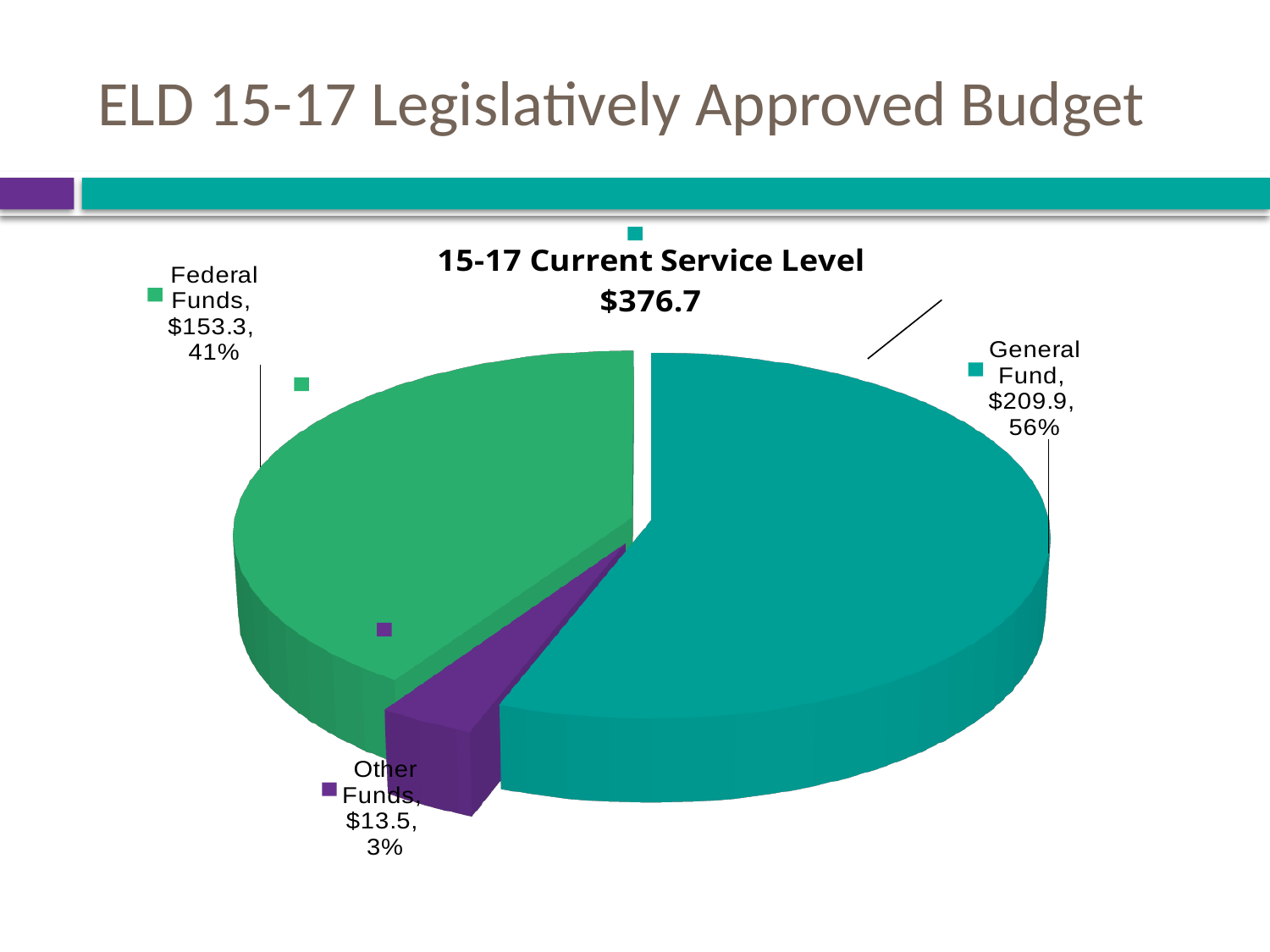
How many slices does the pie chart have? 3 What is the title of the chart? 15-17 Current Service Level $376.7 What share of the pie does General Fund represent? 56% Which category has the largest slice? General Fund What share of the pie does Federal Funds represent? 41% What is the value for Federal Funds? $153.3 What kind of chart is shown on the slide? pie chart What share of the pie does Other Funds represent? 3% What is the value for General Fund? $209.9 What is the value for Other Funds? $13.5 Which category has the smallest slice? Other Funds What is the difference between the General Fund and Federal Funds values? $56.6